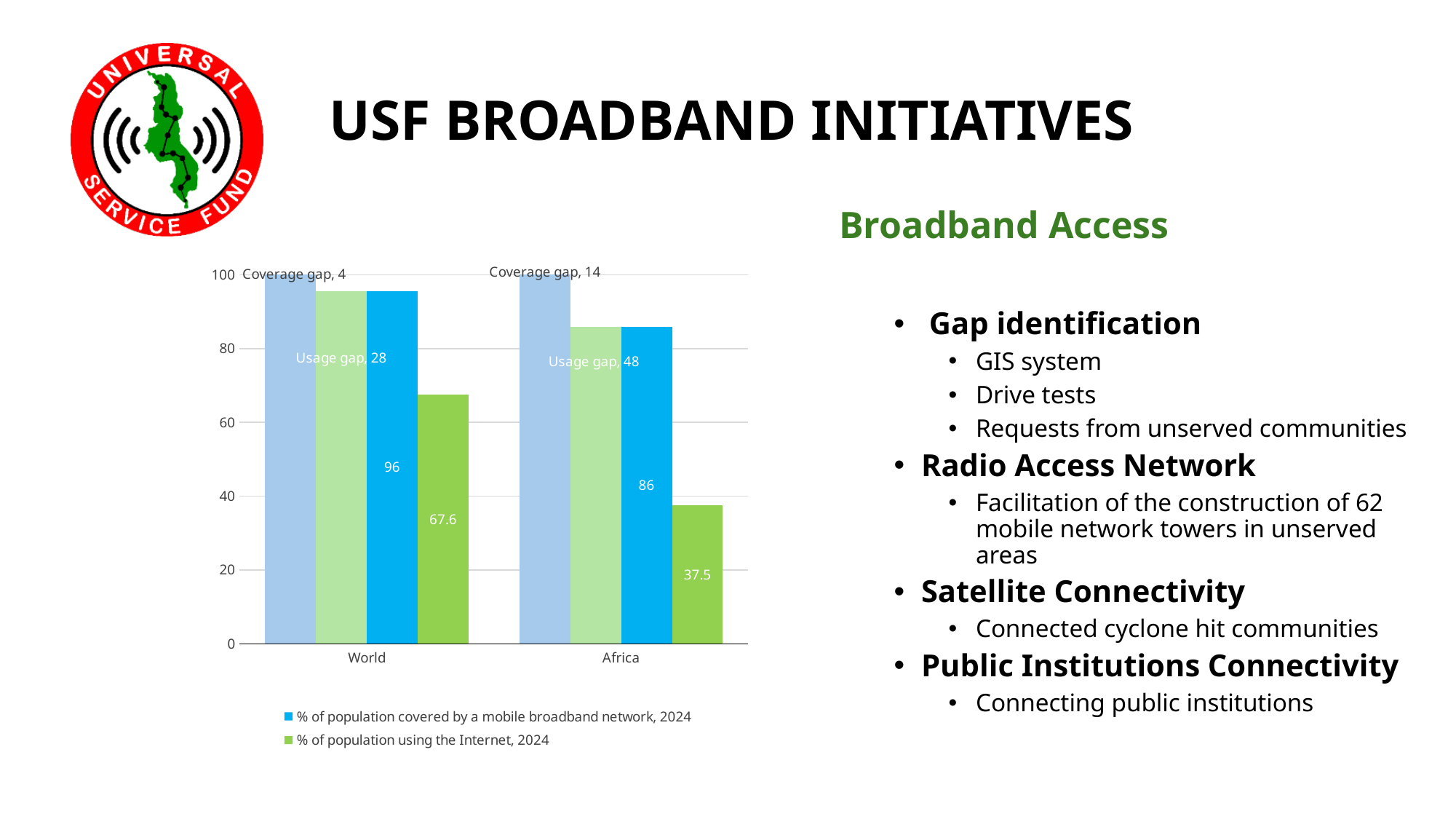
What is the % of population covered by a mobile broadband network, 2024 for World? 96 What is the % of population covered by a mobile broadband network, 2024 for Africa? 86 How many categories are shown on the x axis of the chart? 2 Which region has the higher % of population using the Internet, 2024, World or Africa? World What is the % of population using the Internet, 2024 for Africa? 37.5 How many series does the chart legend list? 2 What is the difference between the % of population using the Internet, 2024 for World and for Africa? 30.1 What is the coverage gap value shown for Africa? 14 What is the difference between the % of population covered by a mobile broadband network, 2024 for World and for Africa? 10 What kind of chart is shown on the slide? Bar chart What is the % of population using the Internet, 2024 for World? 67.6 What is the usage gap value shown for World? 28